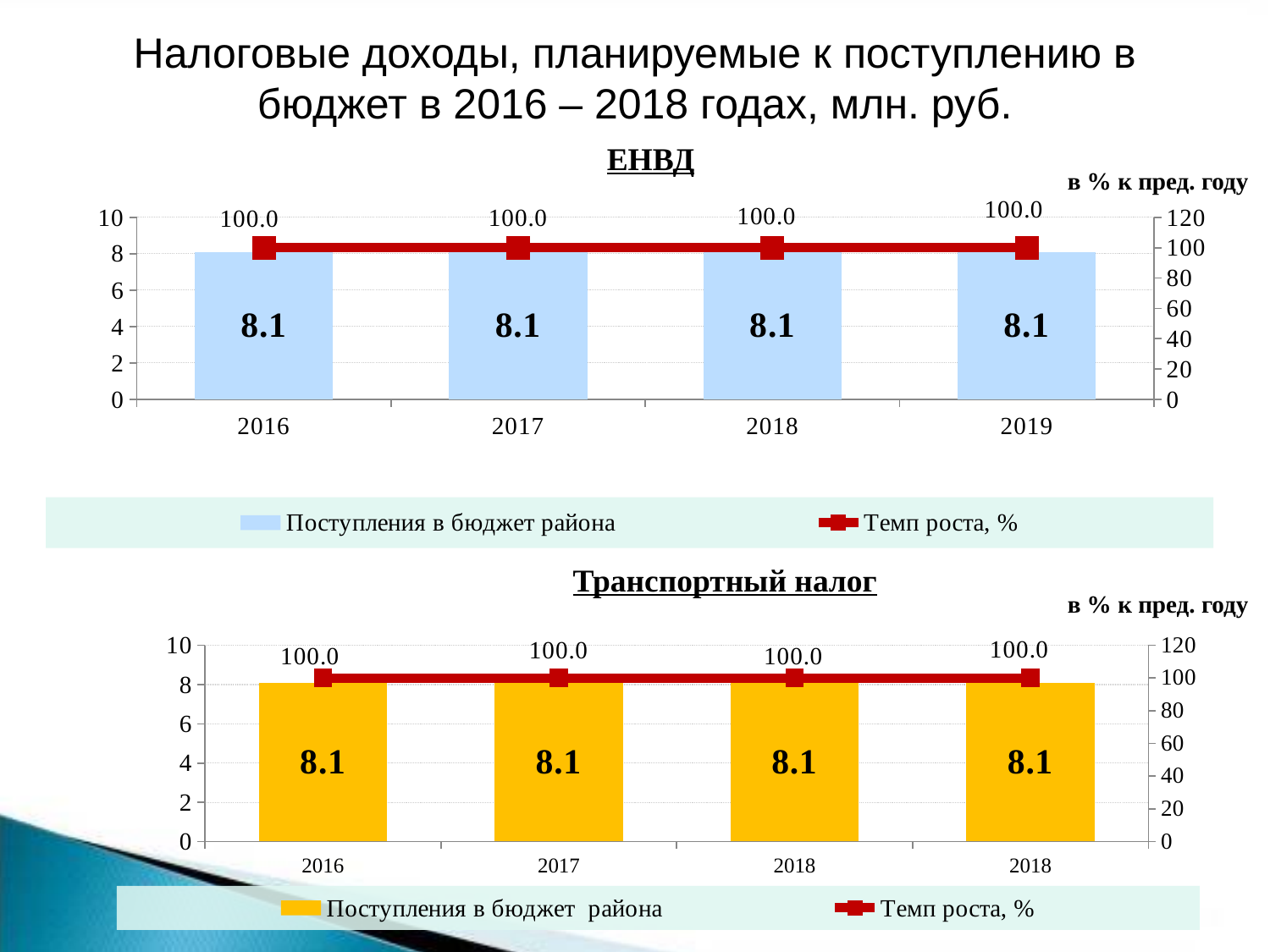
In the Транспортный налог chart, what is the value of Поступления в бюджет района for 2016? 8.1 In the ЕНВД chart, what is the Темп роста, % value for 2019? 100.0 In the Транспортный налог chart, what is the Темп роста, % value for 2017? 100.0 How many bars are plotted in the ЕНВД chart? 4 How many series does the legend of the Транспортный налог chart list? 2 What kind of chart is the ЕНВД chart? Bar chart with a line In the Транспортный налог chart, what is the difference between the Поступления в бюджет района values for 2016 and 2017? 0.0 What colour are the bars in the Транспортный налог chart? Yellow What is the title of the top chart on the slide? ЕНВД In the ЕНВД chart, do the Поступления в бюджет района values rise, fall or stay the same from 2016 to 2019? Stay the same In the ЕНВД chart, what is the value of Поступления в бюджет района for 2017? 8.1 In the ЕНВД chart, is the Темп роста, % value for 2018 greater or less than 80? greater